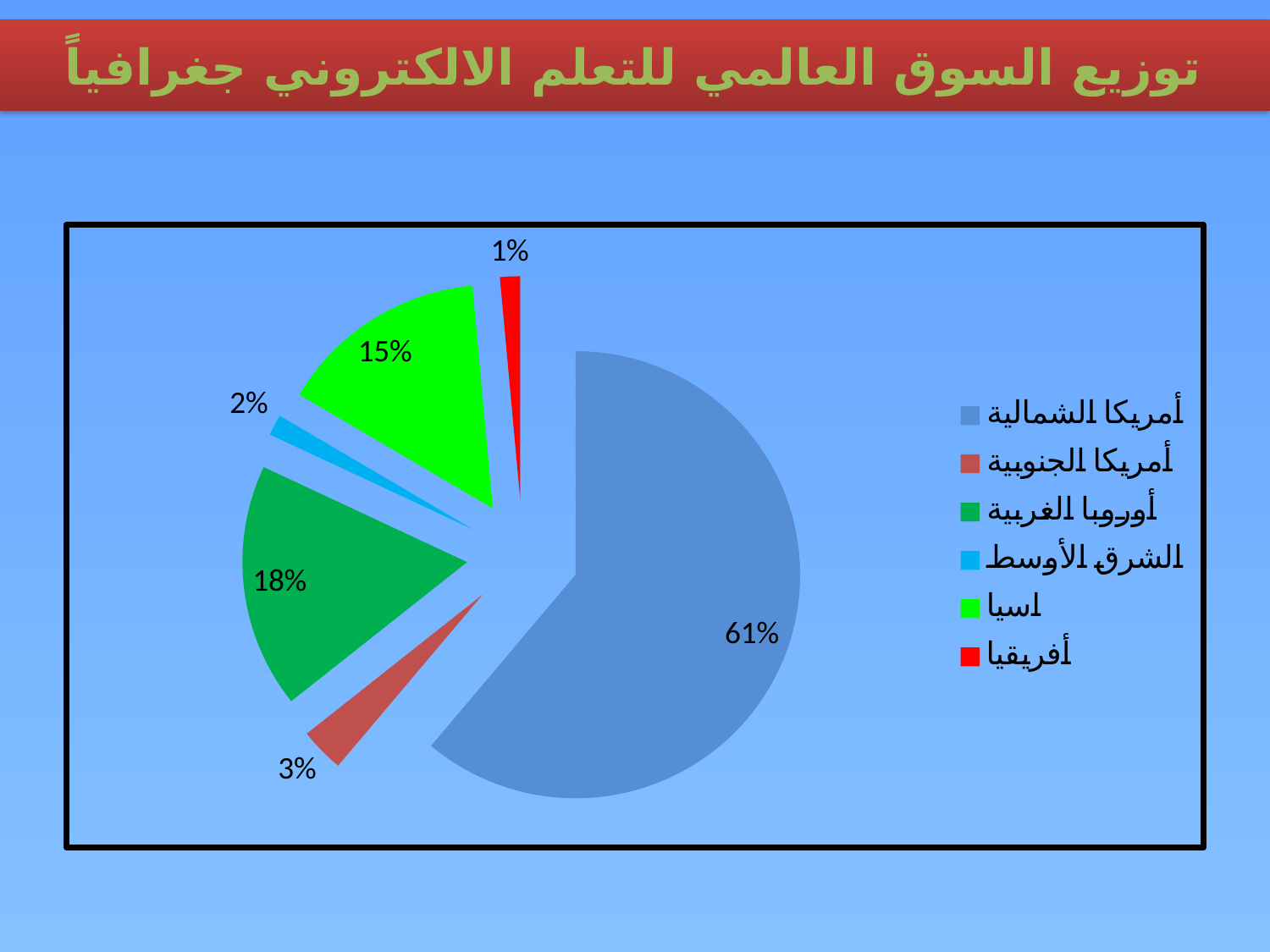
What is the value shown for الشرق الأوسط (Middle East)? 2% What kind of chart is shown on the slide? pie chart What is the difference between the shares of أمريكا الشمالية (North America) and أوروبا الغربية (Western Europe)? 43% Which region has the largest slice of the pie? أمريكا الشمالية What share of the pie does أمريكا الشمالية (North America) hold? 61% Which region has the smallest slice of the pie? أفريقيا What colour is the slice for أفريقيا (Africa)? red What is the value shown for أوروبا الغربية (Western Europe)? 18% What is the value shown for اسيا (Asia)? 15% How many slices does the pie chart have? 6 Which is larger, the share of أمريكا الجنوبية (South America) or the share of الشرق الأوسط (Middle East)? أمريكا الجنوبية What is the difference between the shares of أوروبا الغربية (Western Europe) and اسيا (Asia)? 3%